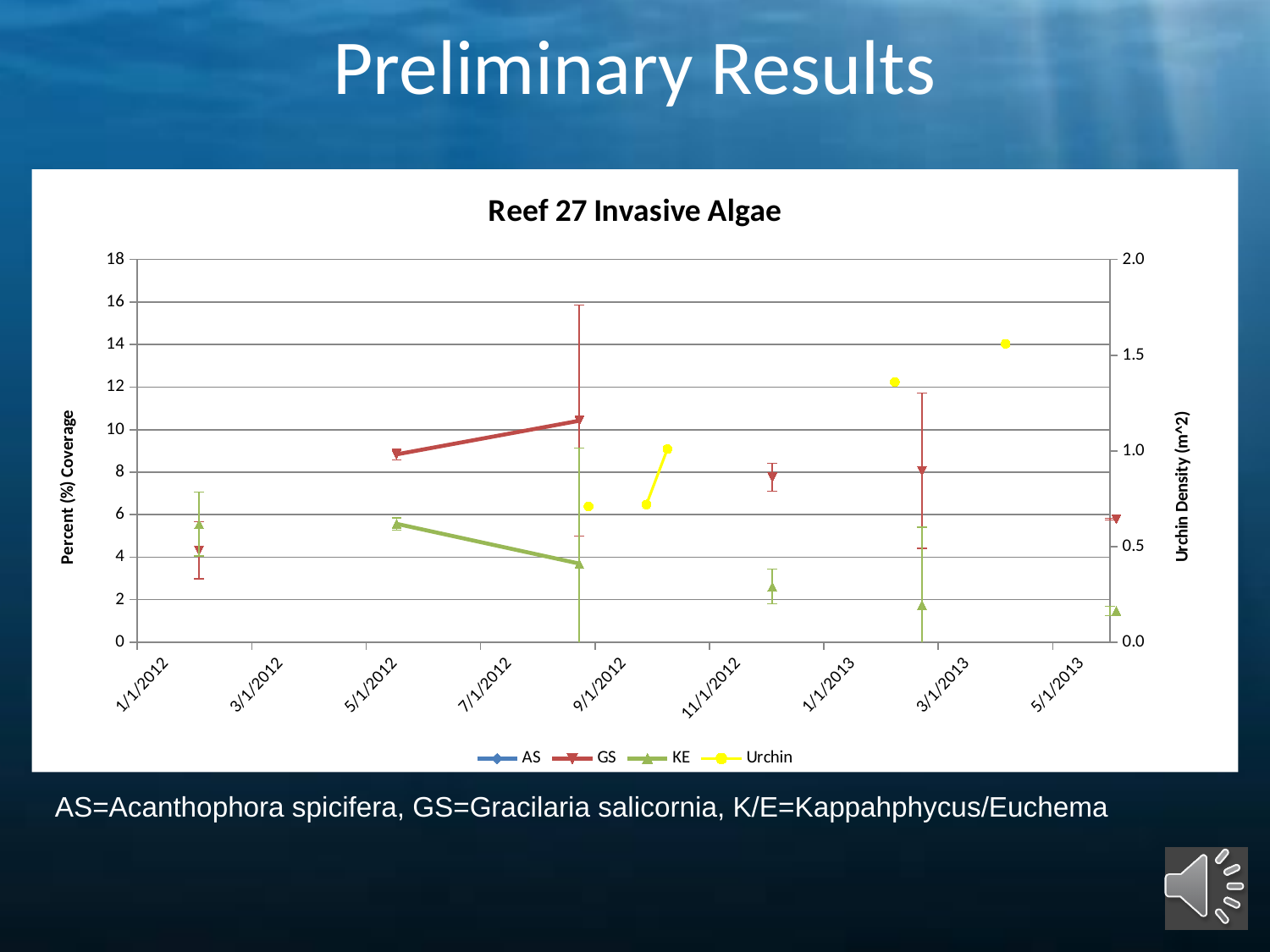
Is the Urchin density at the last (rightmost) yellow point greater or less than 1.0? greater Which series reaches the highest percent coverage on the chart? GS How many series does the legend list? 4 Is the Urchin density at the first (leftmost) yellow point greater or less than 1.0? less What type of chart is shown on the slide? line chart Is the GS value at 5/1/2012 greater or less than 6? greater At 5/1/2012, which series has the higher percent coverage, GS or KE? GS What is the label of the left vertical axis? Percent (%) Coverage What is the title of the chart? Reef 27 Invasive Algae Does the KE series rise or fall between 5/1/2012 and the point just before 9/1/2012? fall